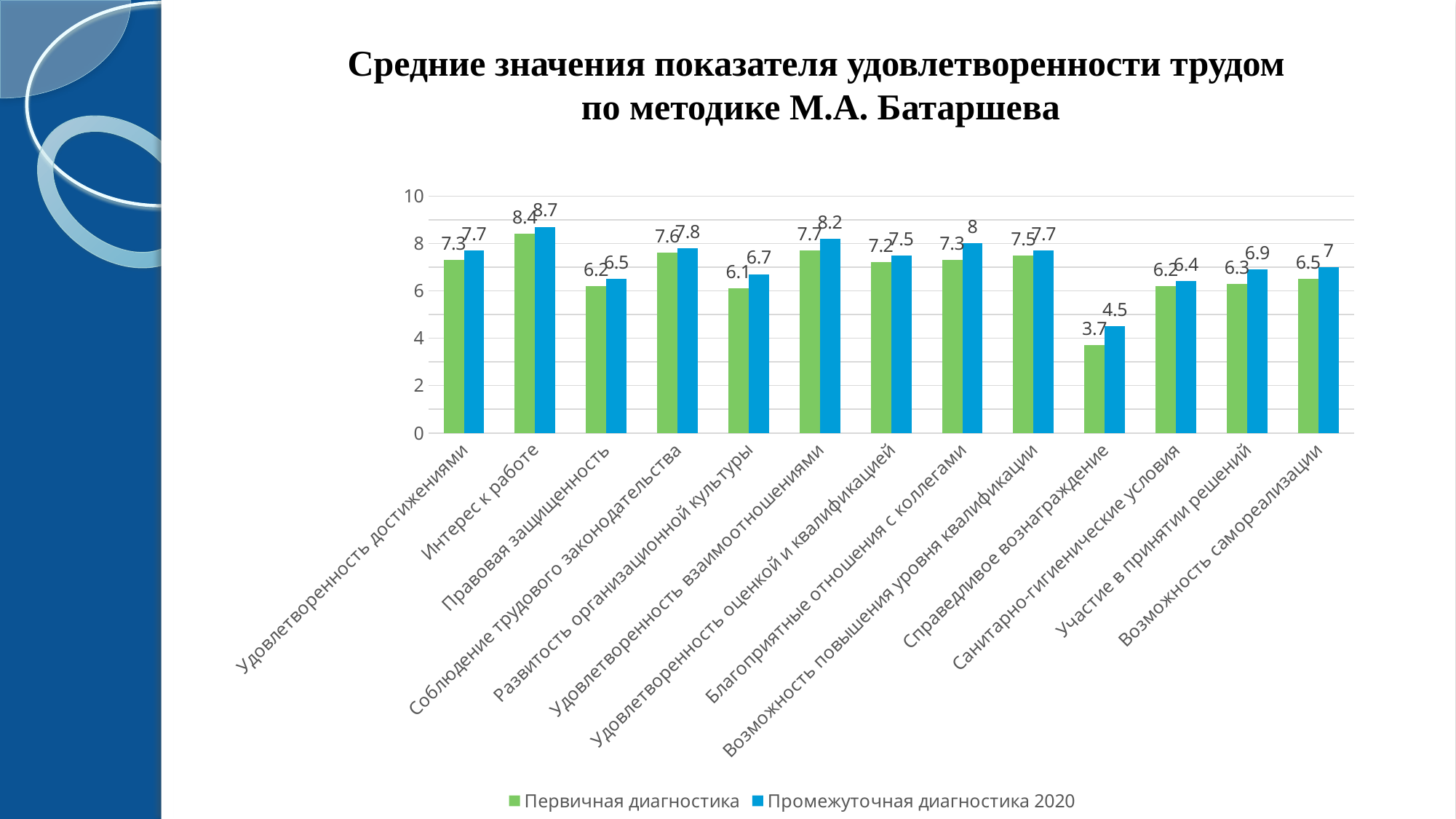
Which is larger for Развитость организационной культуры: Первичная диагностика or Промежуточная диагностика 2020? Промежуточная диагностика 2020 Which category has the highest value for Промежуточная диагностика 2020? Интерес к работе What are the two series listed in the legend? Первичная диагностика and Промежуточная диагностика 2020 What is the difference between Промежуточная диагностика 2020 and Первичная диагностика for Удовлетворенность взаимоотношениями? 0.5 What is the value of Первичная диагностика for Интерес к работе? 8.4 What is the value of Промежуточная диагностика 2020 for Благоприятные отношения с коллегами? 8 What is the value of Промежуточная диагностика 2020 for Справедливое вознаграждение? 4.5 How many series does the legend list? 2 What is the difference between Промежуточная диагностика 2020 and Первичная диагностика for Справедливое вознаграждение? 0.8 How many categories are shown on the x axis of the chart? 13 Which category has the lowest value for Первичная диагностика? Справедливое вознаграждение What type of chart is shown on the slide? bar chart